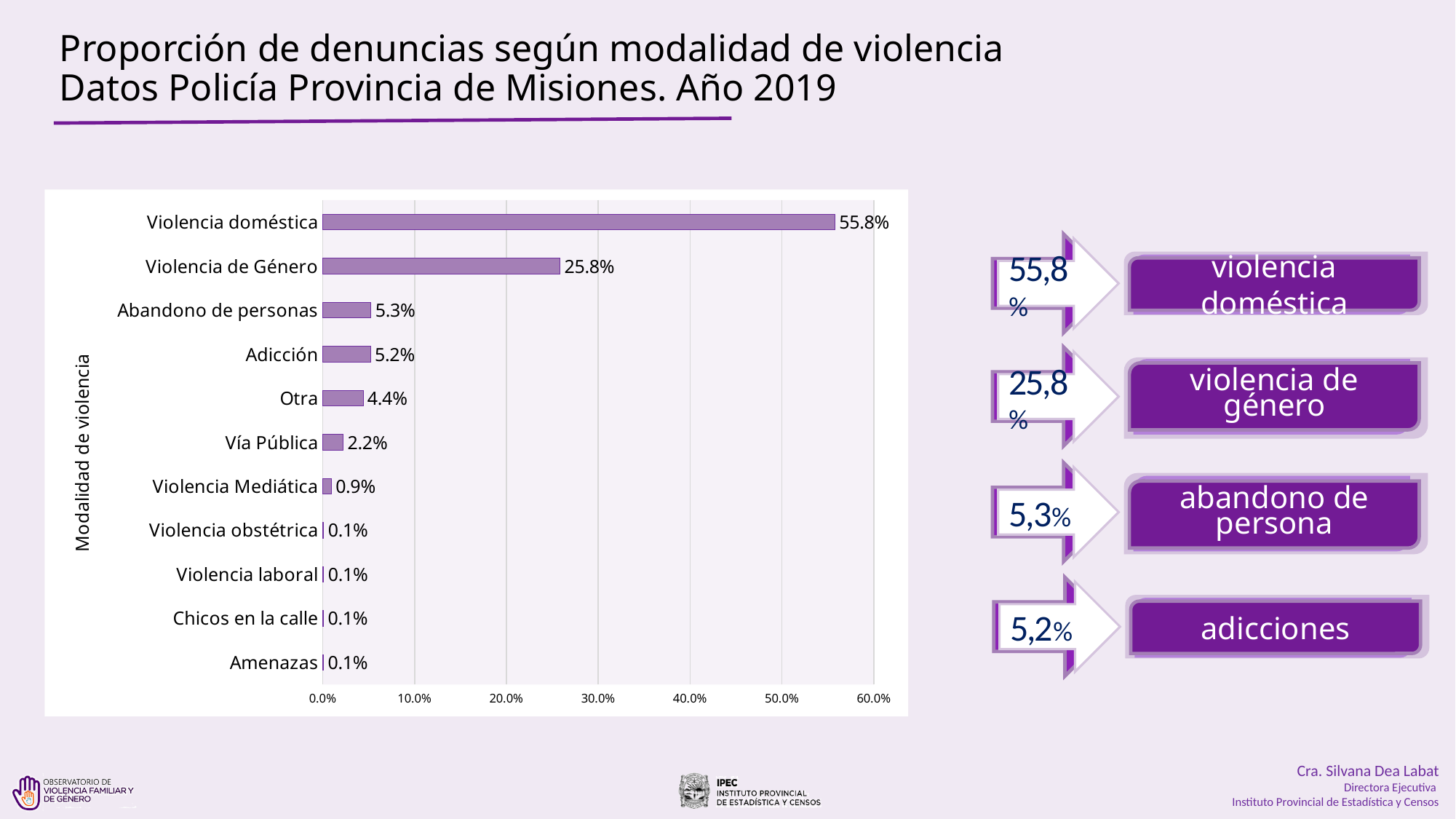
What is the value for Violencia Mediática? 0.9% Which category has the highest value? Violencia doméstica What is the value for Vía Pública? 2.2% What is the label of the vertical axis? Modalidad de violencia What is the value for Violencia de Género? 25.8% What is the difference between the values for Violencia doméstica and Violencia de Género? 30.0% What kind of chart is shown? bar chart What is the value for Violencia doméstica? 55.8% Which is larger, the value for Adicción or the value for Otra? Adicción What is the value for Abandono de personas? 5.3% Is the value for Violencia de Género greater or less than 30.0%? less How many categories are shown on the chart? 11